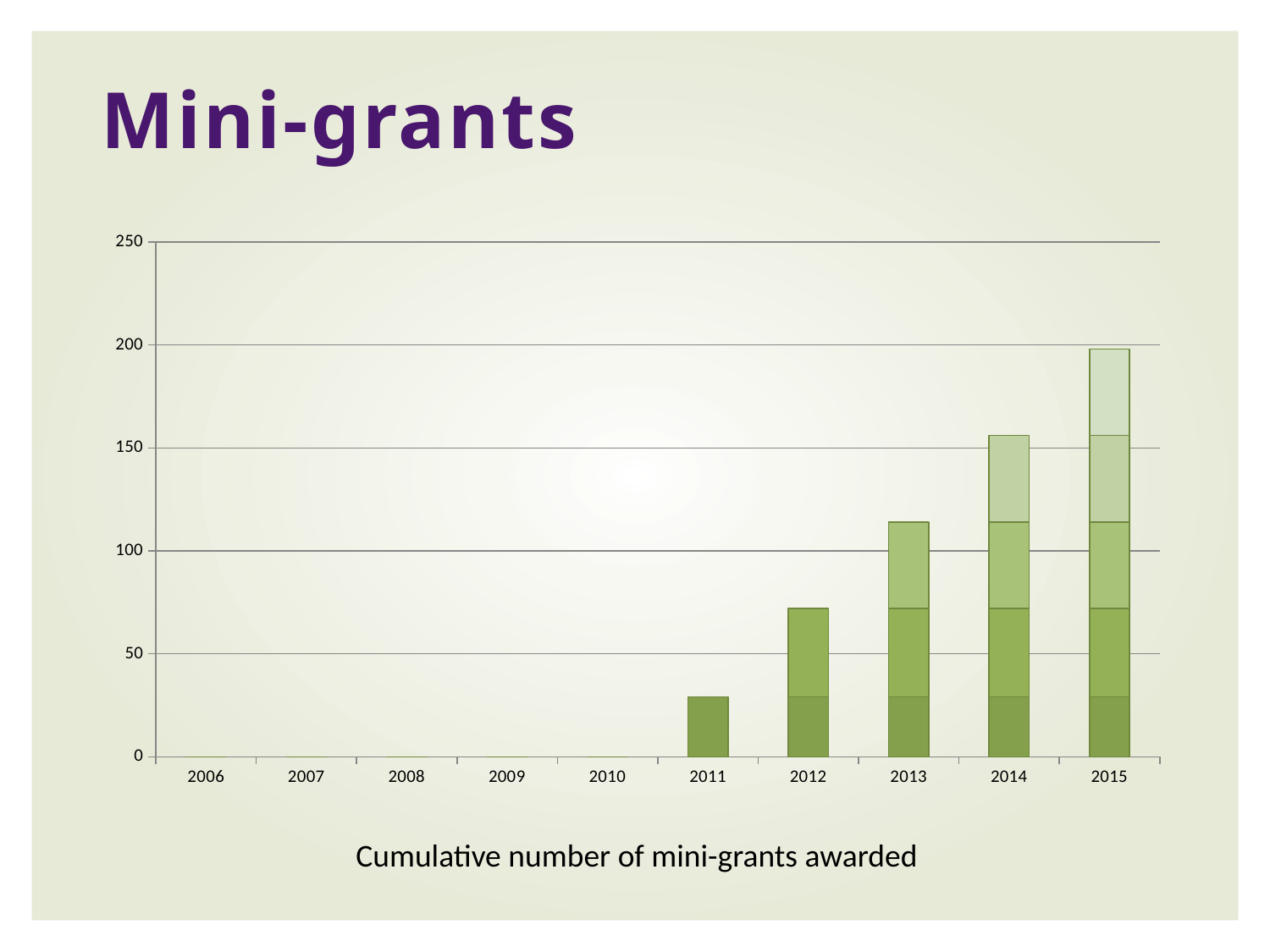
What kind of chart is shown on the slide? Stacked bar chart How many years are shown on the x axis of the chart? 10 Is the value for 2014 greater or less than 200? less Is the value for 2012 greater or less than 50? greater What does the caption below the chart say it shows? Cumulative number of mini-grants awarded Do the values rise or fall from 2011 to 2015? rise Is the value for 2011 greater or less than 50? less Which year has the highest cumulative number of mini-grants awarded? 2015 Which year has the larger value, 2012 or 2011? 2012